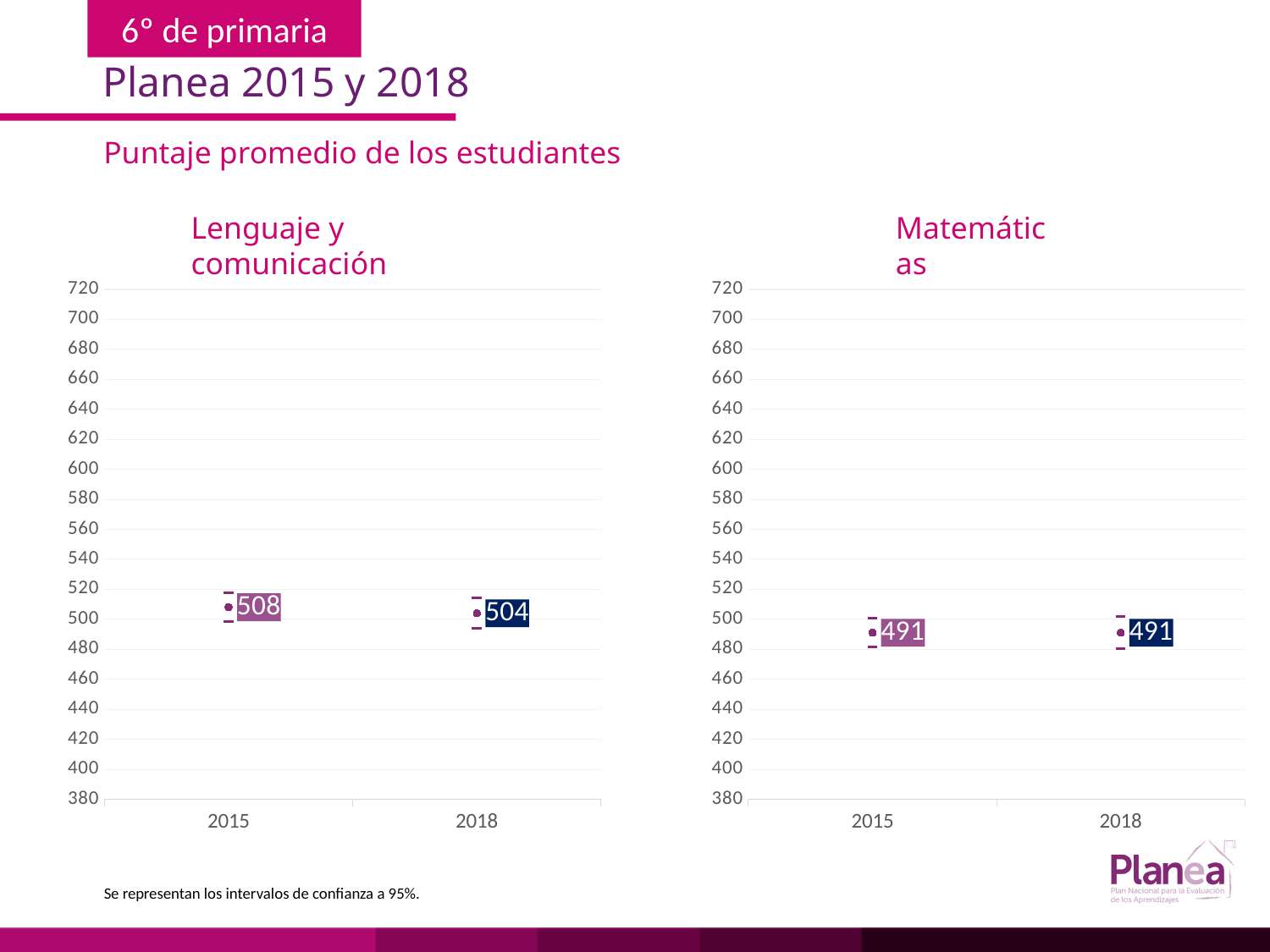
In the Lenguaje y comunicación chart, what is the average score for 2018? 504 In the Matemáticas chart, is the value for 2018 greater or less than 500? less How many years are plotted in the Lenguaje y comunicación chart? 2 In the Lenguaje y comunicación chart, which year has the higher score, 2015 or 2018? 2015 In the Matemáticas chart, what is the average score for 2018? 491 What is the title of the chart on the right side of the slide? Matemáticas In the Lenguaje y comunicación chart, does the score rise or fall from 2015 to 2018? fall In the Lenguaje y comunicación chart, what is the average score for 2015? 508 In the Matemáticas chart, what is the average score for 2015? 491 In the Lenguaje y comunicación chart, what is the difference between the 2015 and 2018 scores? 4 In the Matemáticas chart, what is the difference between the 2015 and 2018 scores? 0 In the Matemáticas chart, does the score rise, fall or stay the same from 2015 to 2018? stay the same